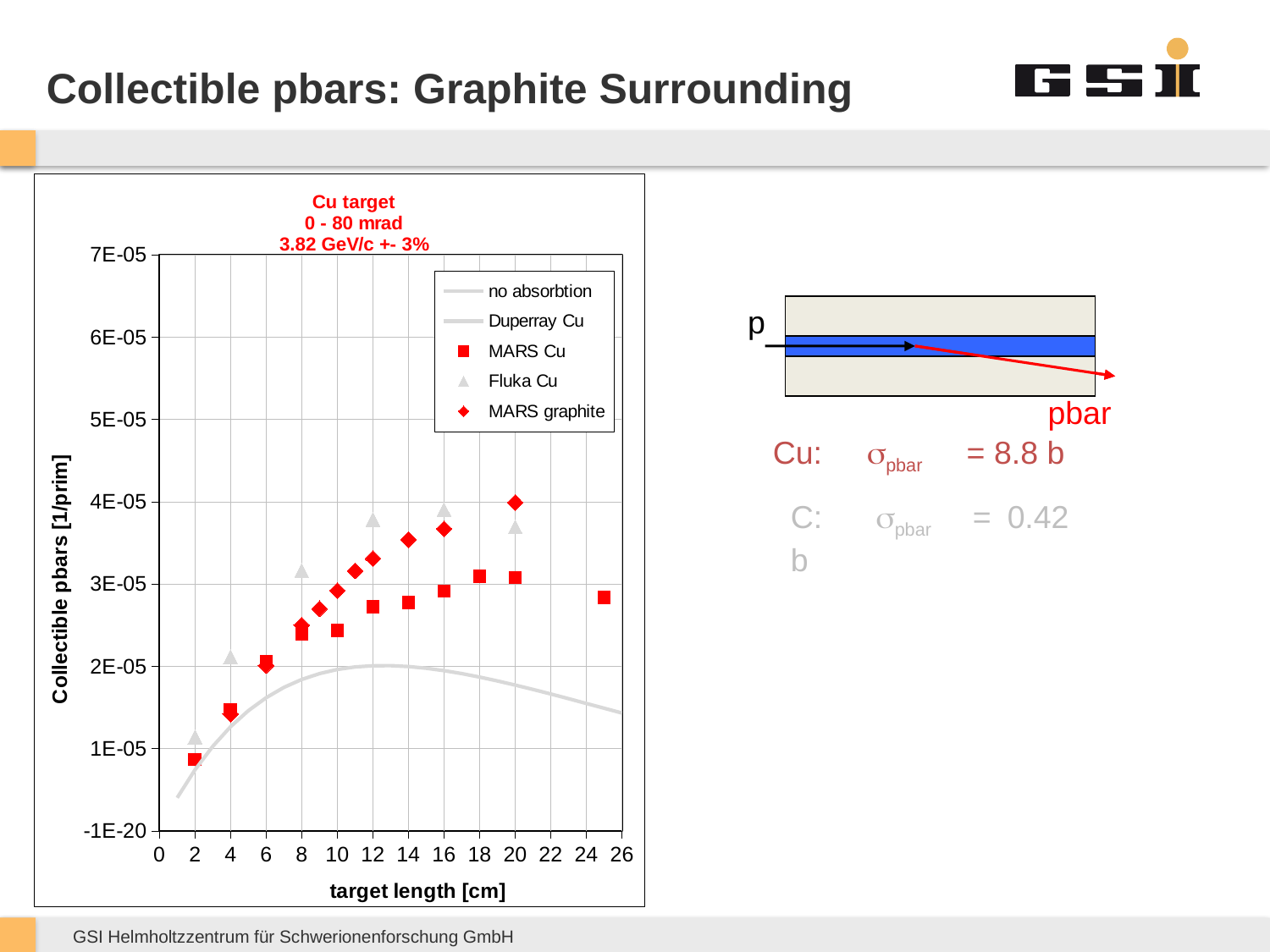
At a target length of 16 cm, which series has the larger value: MARS graphite or MARS Cu? MARS graphite Is the MARS Cu value at a target length of 25 cm greater or less than 3E-05? less Is the MARS Cu value at a target length of 2 cm greater or less than 1E-05? less How many series does the chart legend list? 5 Do the MARS graphite values rise or fall as the target length increases from 4 cm to 20 cm? rise What kind of chart is shown on the slide? scatter chart At a target length of 20 cm, which series has the larger value: Fluka Cu or MARS Cu? Fluka Cu Is the Fluka Cu value at a target length of 12 cm greater or less than 3E-05? greater What is the label of the x axis of the chart? target length [cm] What is the label of the y axis of the chart? Collectible pbars [1/prim]